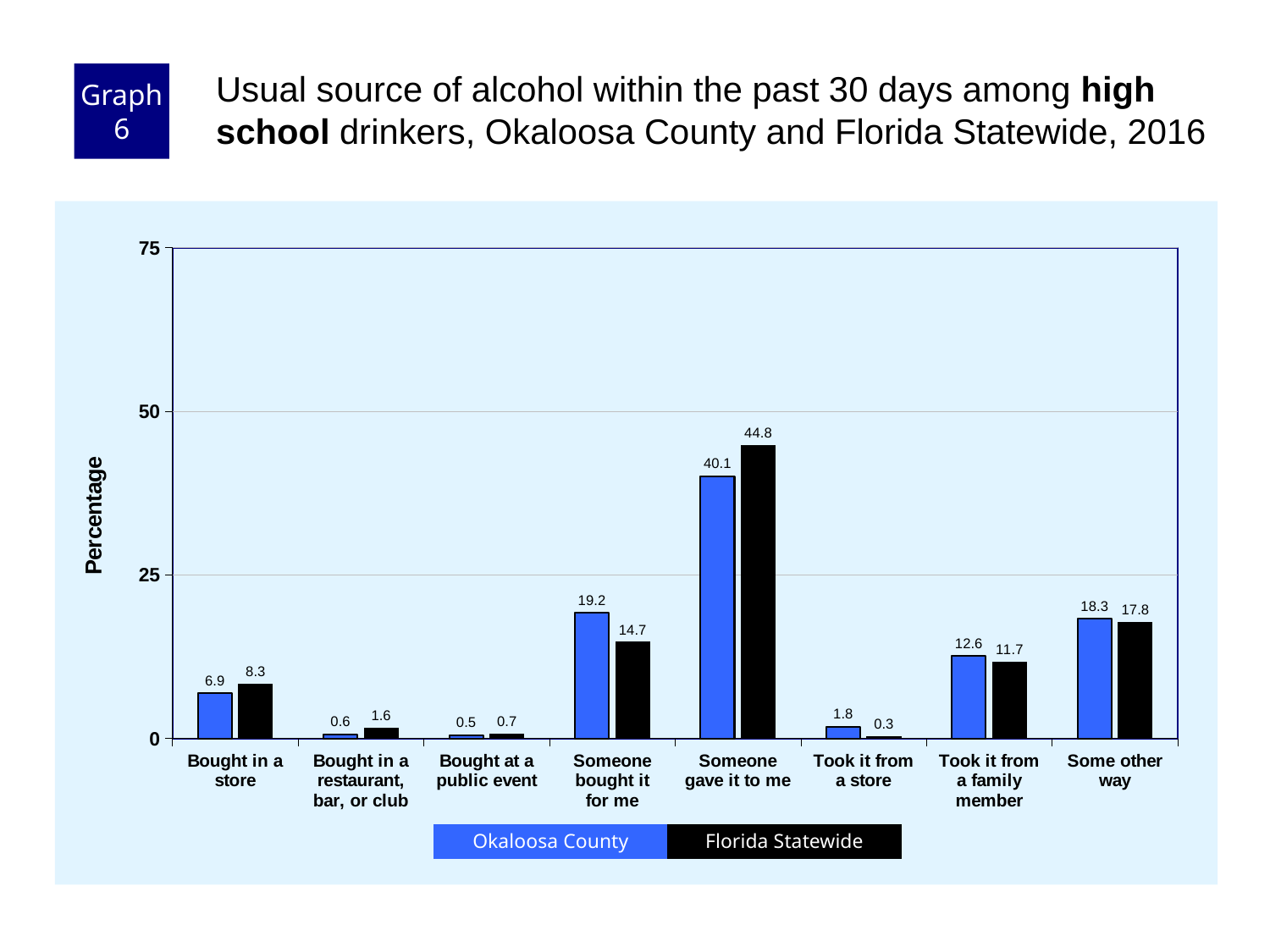
Which category has the highest Florida Statewide value? Someone gave it to me Which is larger for "Someone bought it for me": Okaloosa County or Florida Statewide? Okaloosa County What is the Okaloosa County value for "Someone gave it to me"? 40.1 What is the difference between the Florida Statewide and Okaloosa County values for "Someone gave it to me"? 4.7 Which category has the lowest Okaloosa County value? Bought at a public event What is the Okaloosa County value for "Took it from a family member"? 12.6 Is the Florida Statewide value for "Someone gave it to me" greater or less than 50? less What is the Florida Statewide value for "Bought in a store"? 8.3 What is the label of the y axis? Percentage What kind of chart is shown on the slide? bar chart How many categories are shown on the x axis? 8 How many series does the legend list? 2